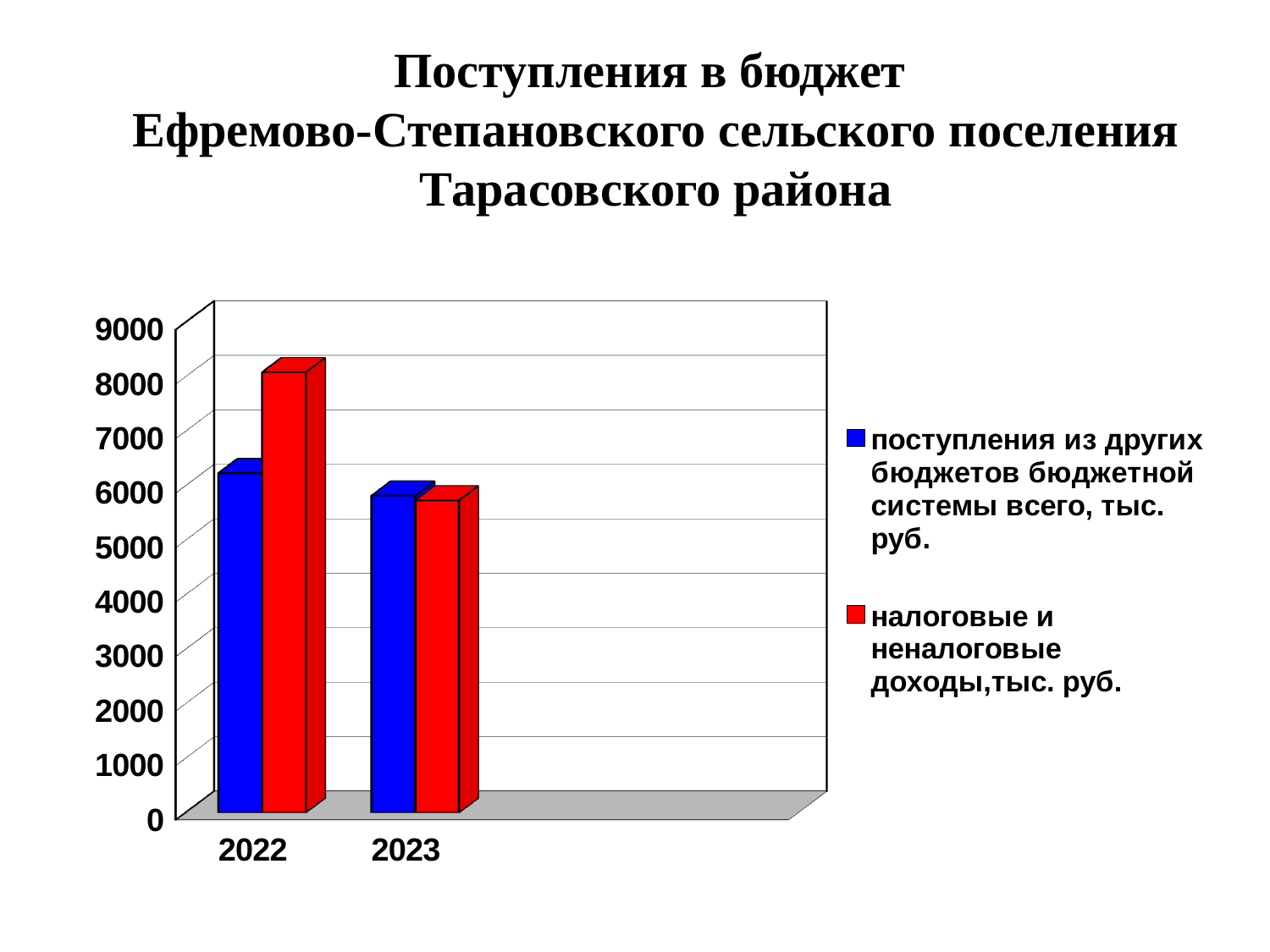
Is the value for 'налоговые и неналоговые доходы' in 2023 greater or less than 7000? less Do the values for 'налоговые и неналоговые доходы' rise or fall from 2022 to 2023? fall Is the value for 'налоговые и неналоговые доходы' in 2022 greater or less than 7000? greater How many years are shown on the x axis of the chart? 2 What kind of chart is shown on the slide? bar chart Which colour represents 'поступления из других бюджетов бюджетной системы всего, тыс. руб.' in the chart? blue Is the value for 'поступления из других бюджетов бюджетной системы всего' in 2023 greater or less than 7000? less In 2022, which is larger: 'налоговые и неналоговые доходы' or 'поступления из других бюджетов бюджетной системы всего'? налоговые и неналоговые доходы How many series does the chart legend list? 2 In which year is the value for 'налоговые и неналоговые доходы' highest? 2022 Which colour represents 'налоговые и неналоговые доходы, тыс. руб.' in the chart? red